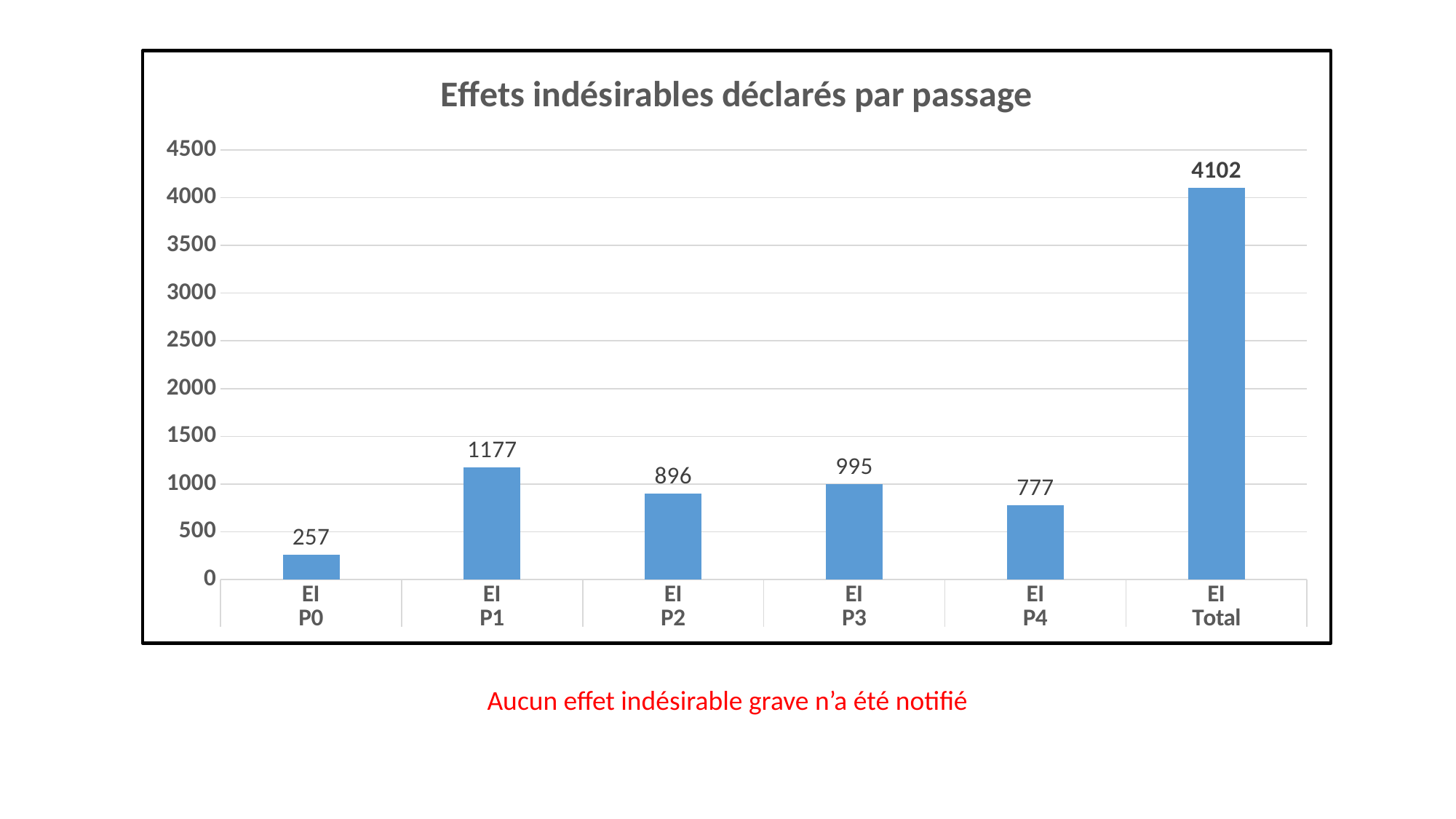
Is the value for EI P2 greater or less than 1000? less What is the value for EI P4? 777 What is the difference between the values for EI P3 and EI P0? 738 Which category has the highest value? EI Total What is the value for EI Total? 4102 Which is larger, the value for EI P3 or the value for EI P4? EI P3 What kind of chart is shown on the slide? bar chart What is the difference between the values for EI P1 and EI P2? 281 How many categories are shown on the x axis? 6 Which category has the lowest value? EI P0 What is the value for EI P1? 1177 What is the title of the chart? Effets indésirables déclarés par passage